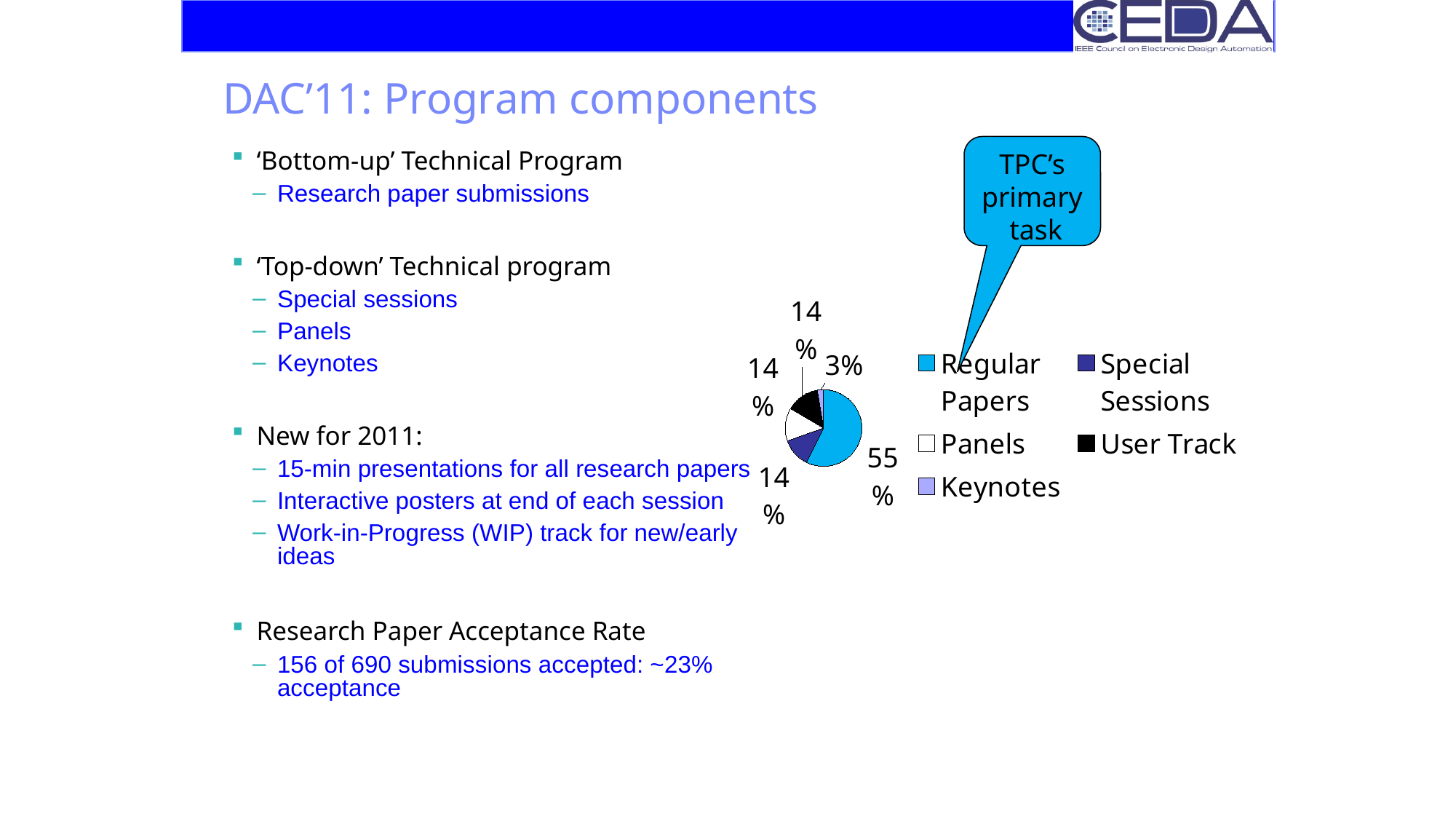
Which category has the largest slice in the pie chart? Regular Papers What kind of chart is shown on the slide? pie chart What share of the pie chart is Panels? 14% Which is larger in the pie chart, Regular Papers or Keynotes? Regular Papers What colour is the Regular Papers slice in the pie chart? cyan (light blue) What is the difference between the Regular Papers share and the Keynotes share? 52 percentage points Which category has the smallest slice in the pie chart? Keynotes How many entries does the pie chart's legend list? 5 How many slices does the pie chart have? 5 What share of the pie chart is Keynotes? 3% What share of the pie chart is Regular Papers? 55% Which legend entry is shown in black in the pie chart? User Track